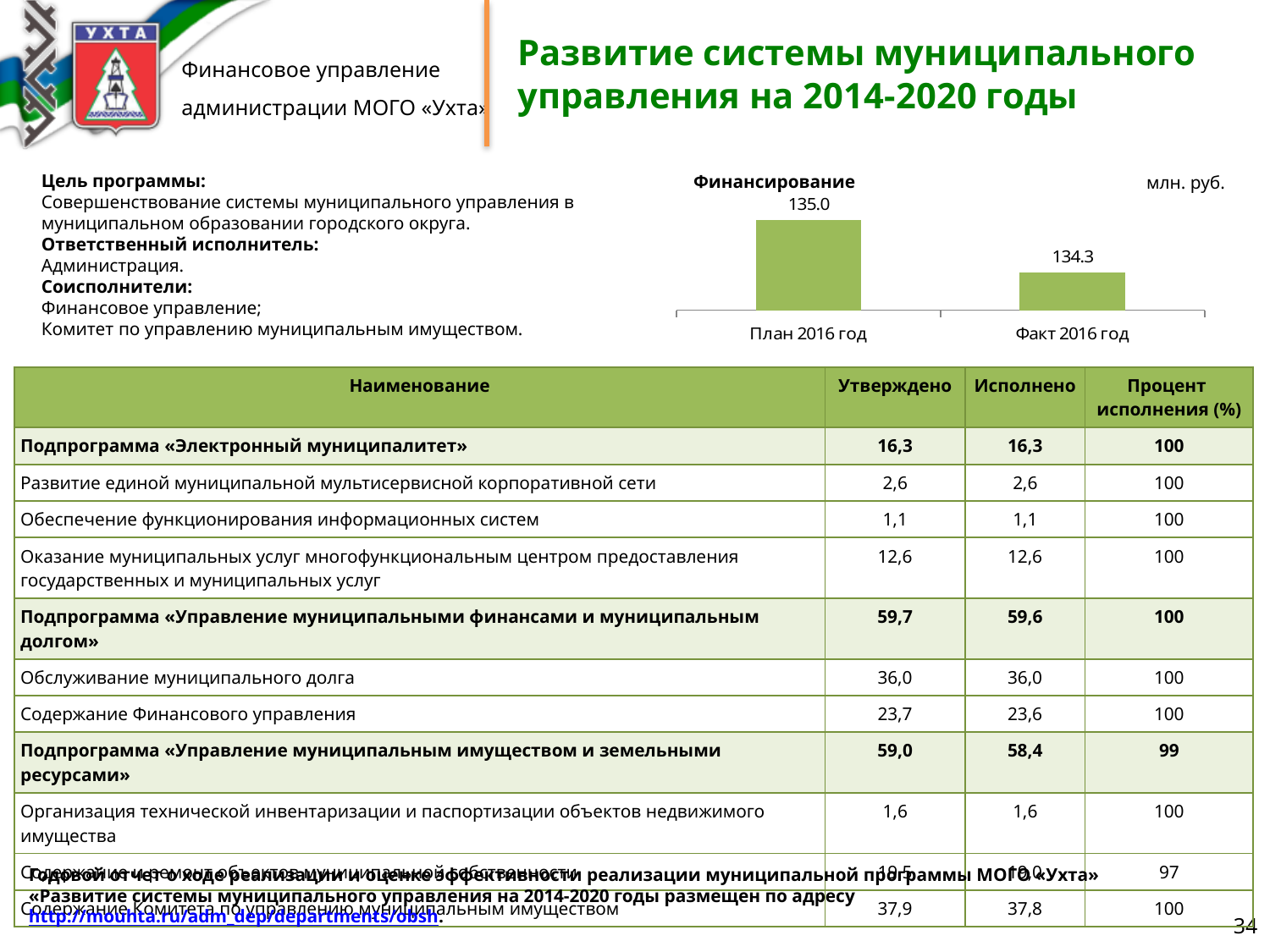
In the Финансирование chart, which is larger: План 2016 год or Факт 2016 год? План 2016 год Which category has the lowest value in the Финансирование chart? Факт 2016 год What is the value for План 2016 год in the Финансирование chart? 135.0 What is the title of the chart on the slide? Финансирование What unit is indicated for the values in the Финансирование chart? млн. руб. How many bars are shown in the Финансирование chart? 2 What is the value for Факт 2016 год in the Финансирование chart? 134.3 What kind of chart is the Финансирование chart? bar chart Which category has the highest value in the Финансирование chart? План 2016 год What is the difference between План 2016 год and Факт 2016 год in the Финансирование chart? 0.7 Do the values in the Финансирование chart rise or fall from План 2016 год to Факт 2016 год? fall